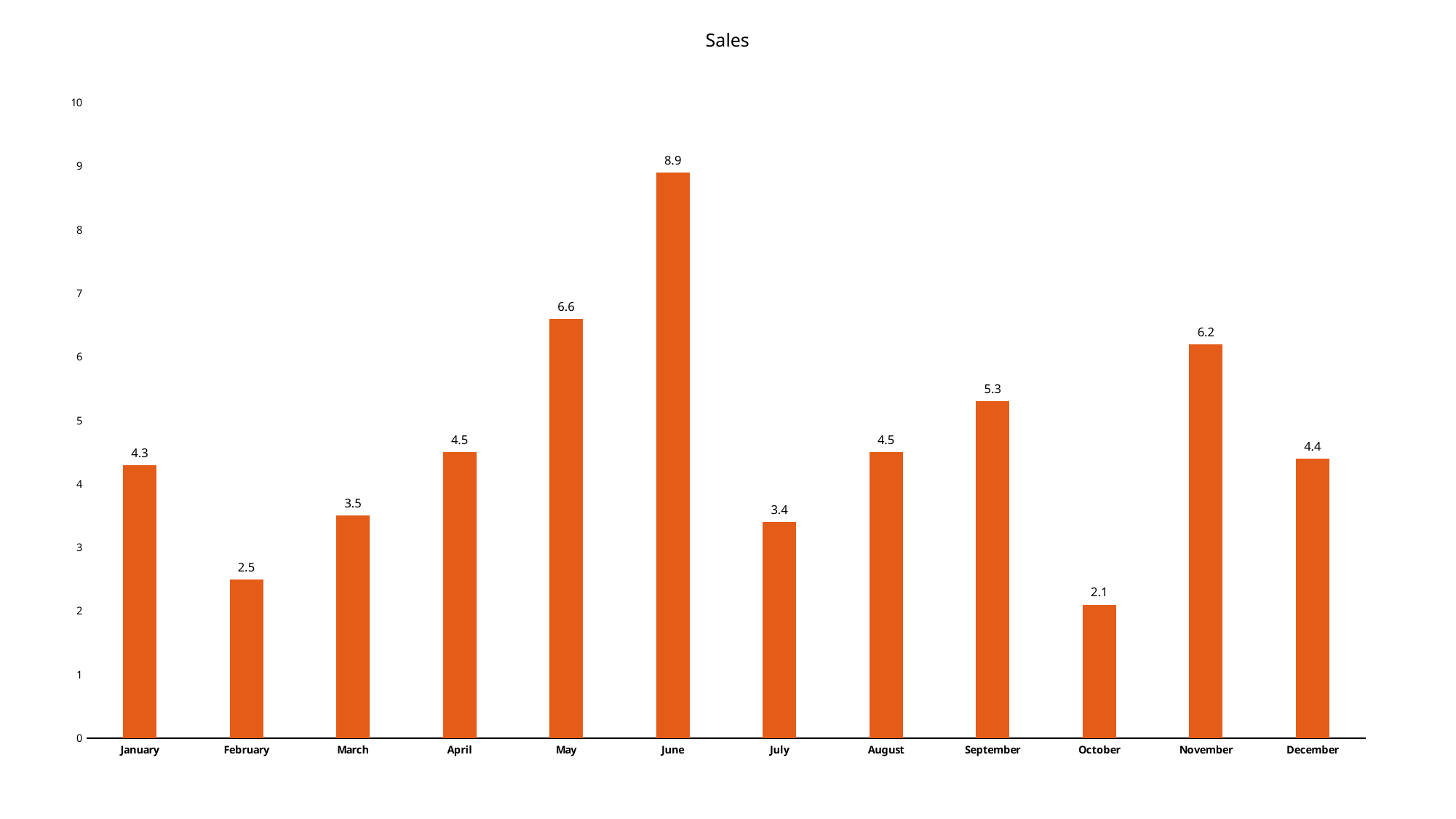
Which month has the lowest value? October What is the difference between the values for June and May? 2.3 What is the difference between the values for January and February? 1.8 Which month has the highest value? June What is the value for November? 6.2 What is the value for October? 2.1 What is the title of the chart? Sales What is the value for June? 8.9 Which is larger, the value for September or the value for December? September Is the value for May greater or less than 6? greater How many months are shown on the x axis? 12 What kind of chart is shown on the slide? Bar chart